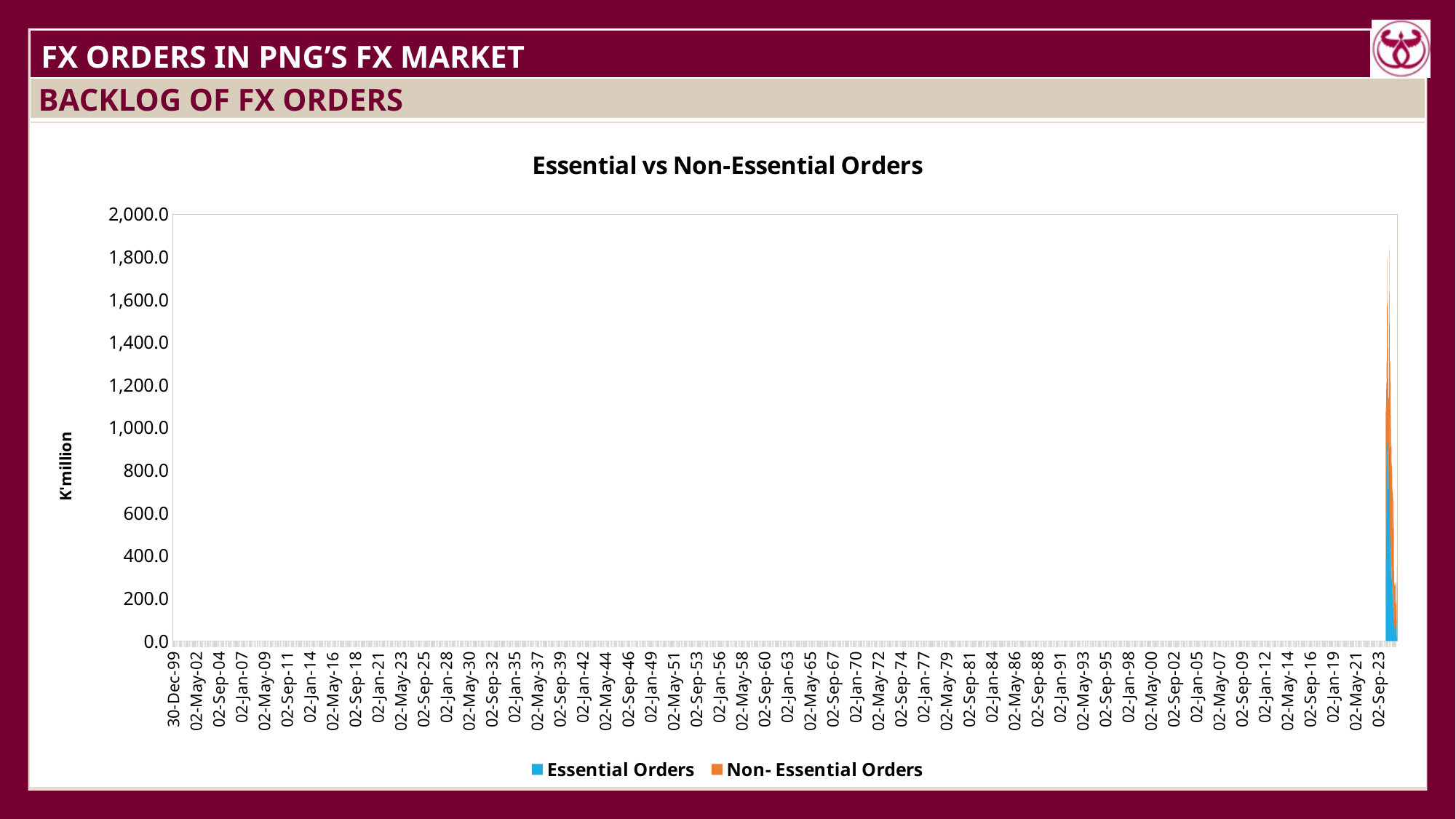
Is the highest point of the stacked total greater or less than 2,000.0? less How many series does the chart's legend list? 2 What are the two series named in the legend? Essential Orders and Non- Essential Orders What kind of chart is shown on the slide? area chart What is the title of the chart? Essential vs Non-Essential Orders Is the highest point of the stacked total greater or less than 1,000.0? greater